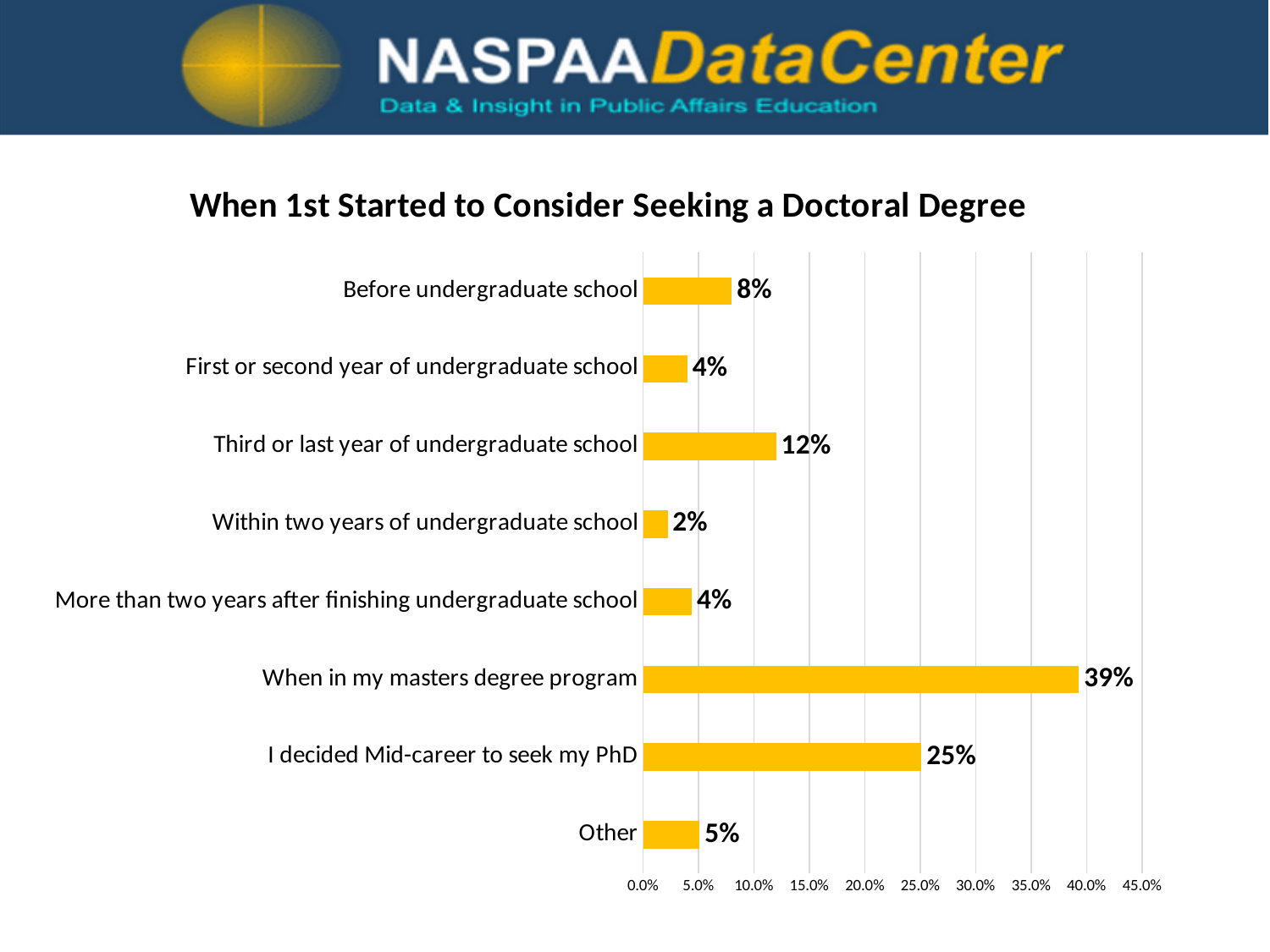
What is the value for 'I decided Mid-career to seek my PhD'? 25% What percentage of respondents first considered seeking a doctoral degree when in their masters degree program? 39% What is the value for 'Third or last year of undergraduate school'? 12% Is the value for 'I decided Mid-career to seek my PhD' greater or less than 20.0%? greater What is the difference between the values for 'When in my masters degree program' and 'I decided Mid-career to seek my PhD'? 14% What is the title of the chart? When 1st Started to Consider Seeking a Doctoral Degree How many categories are shown in the chart? 8 Which category has the highest value? When in my masters degree program What kind of chart is shown on the slide? Bar chart Which category has the lowest value? Within two years of undergraduate school Which is larger: the value for 'Before undergraduate school' or the value for 'Third or last year of undergraduate school'? Third or last year of undergraduate school What is the value for 'Other'? 5%